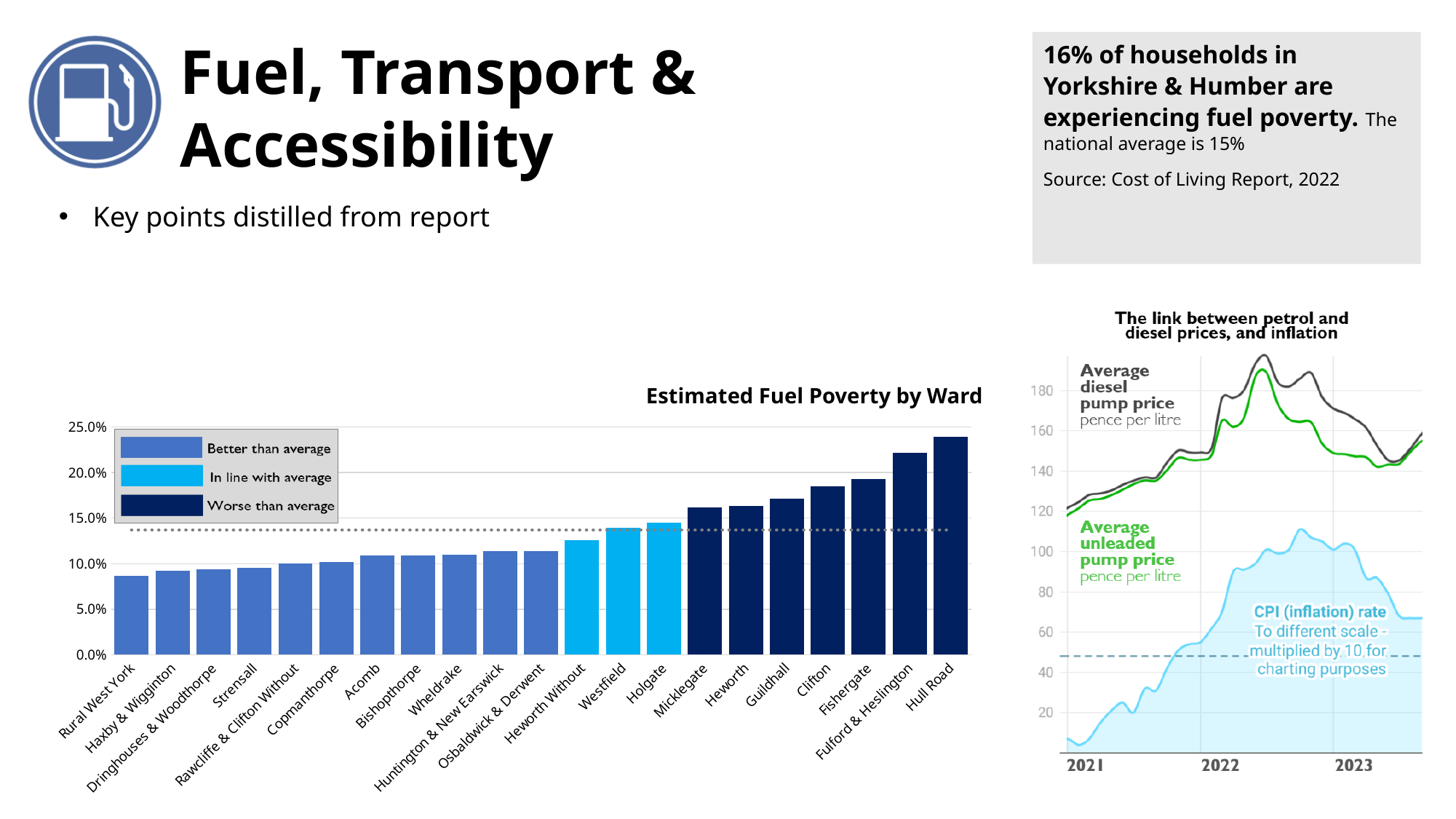
In the 'Estimated Fuel Poverty by Ward' chart, is the value for Rural West York greater or less than 10.0%? less In the 'Estimated Fuel Poverty by Ward' chart, which legend entry is shown in the darkest colour? Worse than average What kind of chart is 'The link between petrol and diesel prices, and inflation'? line chart In 'The link between petrol and diesel prices, and inflation' chart, does the CPI (inflation) rate rise or fall from the start of 2021 to the start of 2022? rise In the 'Estimated Fuel Poverty by Ward' chart, which ward has the lowest estimated fuel poverty? Rural West York What kind of chart is the 'Estimated Fuel Poverty by Ward' chart? bar chart In the 'Estimated Fuel Poverty by Ward' chart, is the value for Fishergate greater or less than 15.0%? greater In the 'Estimated Fuel Poverty by Ward' chart, which ward has the highest estimated fuel poverty? Hull Road In the 'Estimated Fuel Poverty by Ward' chart, how many entries does the legend list? 3 In the 'Estimated Fuel Poverty by Ward' chart, how many wards are shown on the x axis? 21 In the 'Estimated Fuel Poverty by Ward' chart, is the value for Hull Road greater or less than 20.0%? greater In the 'Estimated Fuel Poverty by Ward' chart, which is larger, the value for Fulford & Heslington or the value for Fishergate? Fulford & Heslington